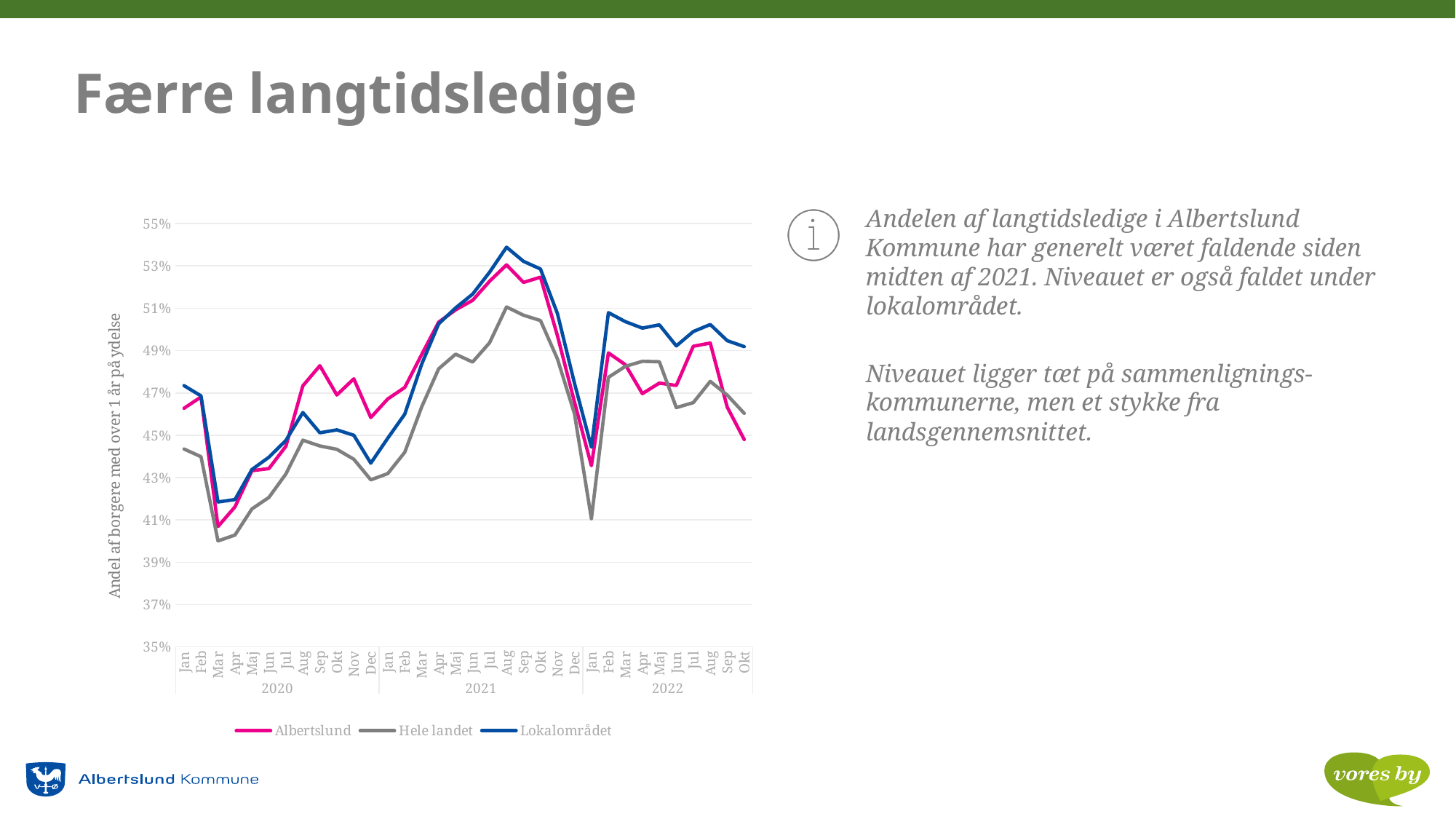
What is the label of the vertical axis? Andel af borgere med over 1 år på ydelse How many series does the legend list? 3 Does the Albertslund line rise or fall from Aug 2022 to Okt 2022? Fall Is the value for Lokalområdet in Aug 2021 greater or less than 53%? greater Which series are listed in the legend? Albertslund, Hele landet, Lokalområdet What kind of chart is shown on the slide? Line chart In Okt 2022, which is larger: Albertslund or Lokalområdet? Lokalområdet Which series reaches the highest value on the chart? Lokalområdet Is the value for Hele landet in Mar 2020 greater or less than 41%? less Which series has the lowest value on the chart? Hele landet In which month does the Albertslund line reach its peak? Aug 2021 How many monthly data points does each line cover, from Jan 2020 to Okt 2022? 34